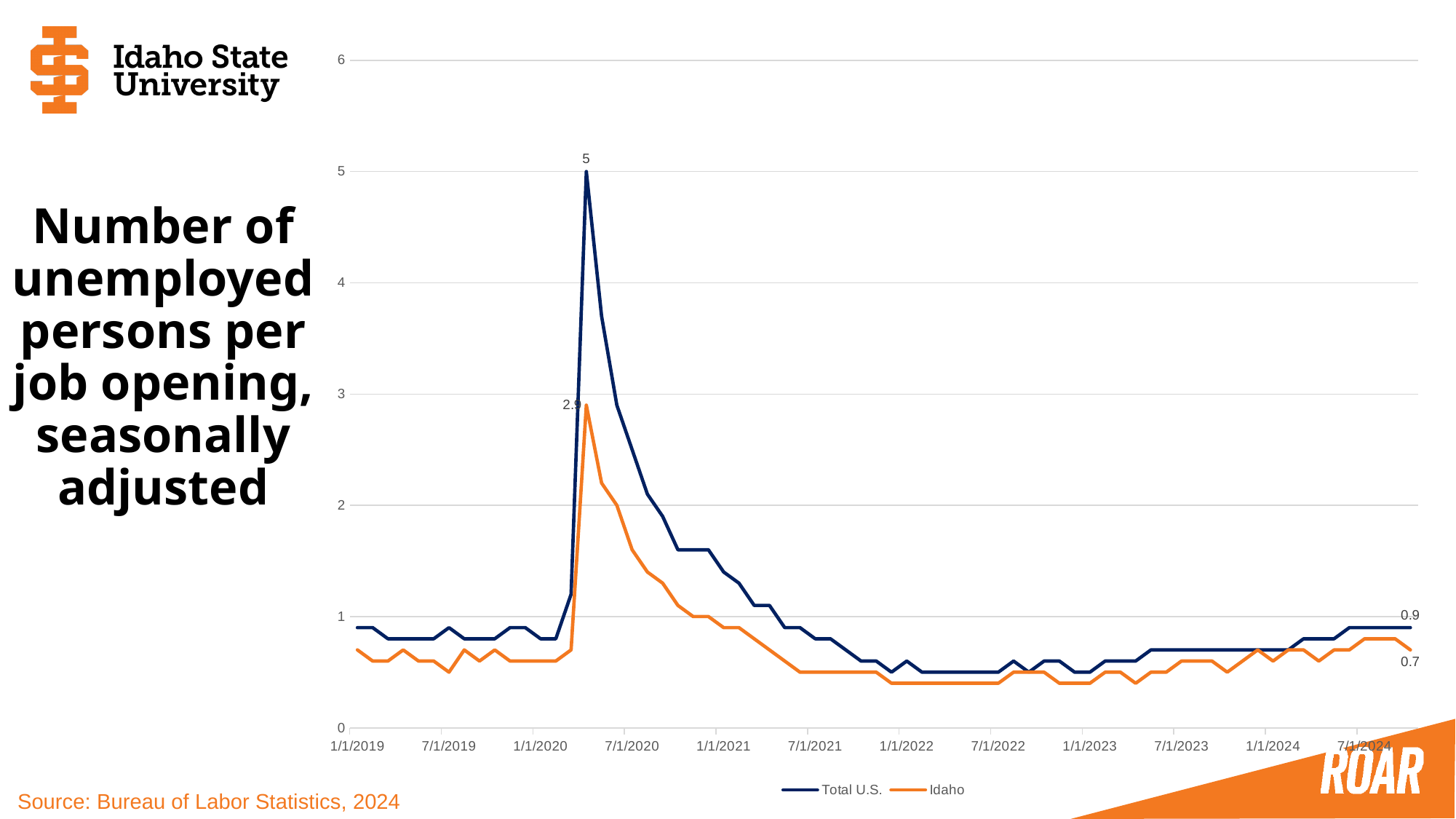
Do the values for both series rise or fall between mid-2020 and 1/1/2022? fall What is the final labelled value for the Total U.S. series at the right end of the chart? 0.9 Is the value for Total U.S. at 1/1/2019 greater or less than 1? less What kind of chart is shown on the slide? line chart What is the peak value labelled for the Total U.S. series? 5 What colour is the line for the Idaho series? orange What is the difference between the labelled peak values of Total U.S. and Idaho? 2.1 How many series does the legend list? 2 What is the difference between the final labelled values of Total U.S. (0.9) and Idaho (0.7)? 0.2 What is the peak value labelled for the Idaho series? 2.9 What is the final labelled value for the Idaho series at the right end of the chart? 0.7 Which series reaches the highest value on the chart? Total U.S.